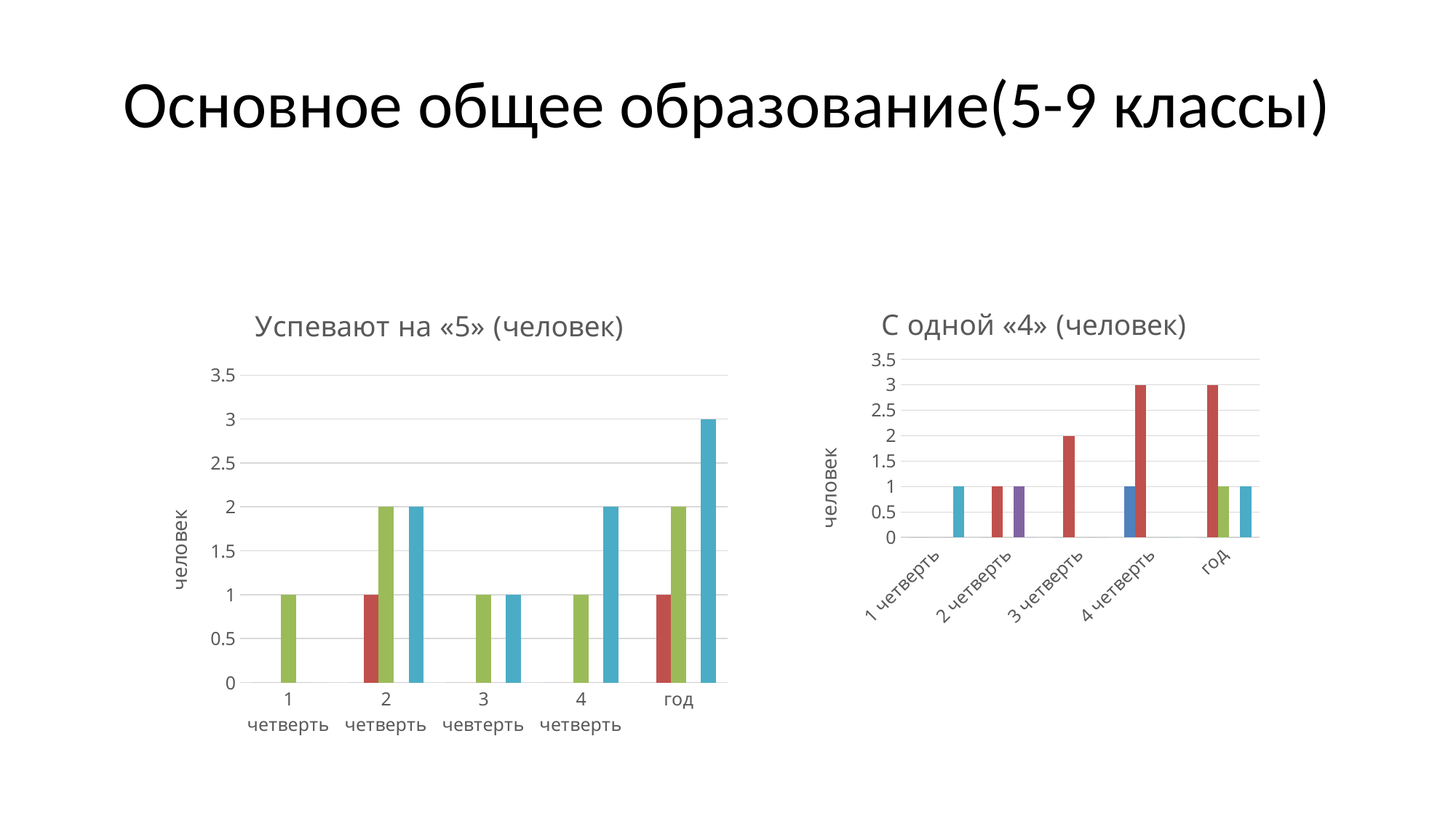
What is the label of the vertical axis on the right chart «С одной «4» (человек)»? человек In the left chart «Успевают на «5» (человек)», which category contains the tallest bar? год In the left chart «Успевают на «5» (человек)», what is the value of the blue bar for «год»? 3 In the left chart «Успевают на «5» (человек)», is the blue bar for «2 четверть» larger or smaller than the red bar for «2 четверть»? larger What is the title of the right chart? С одной «4» (человек) In the right chart «С одной «4» (человек)», is the red bar for «4 четверть» greater or less than 2? greater In the left chart «Успевают на «5» (человек)», what is the difference between the blue bar for «год» and the blue bar for «4 четверть»? 1 What kind of chart is the left chart titled «Успевают на «5» (человек)»? bar chart In the right chart «С одной «4» (человек)», what is the value of the red bar for «4 четверть»? 3 In the left chart «Успевают на «5» (человек)», what is the value of the green bar for «2 четверть»? 2 How many categories are shown on the x axis of the left chart «Успевают на «5» (человек)»? 5 In the right chart «С одной «4» (человек)», what is the value of the red bar for «3 четверть»? 2